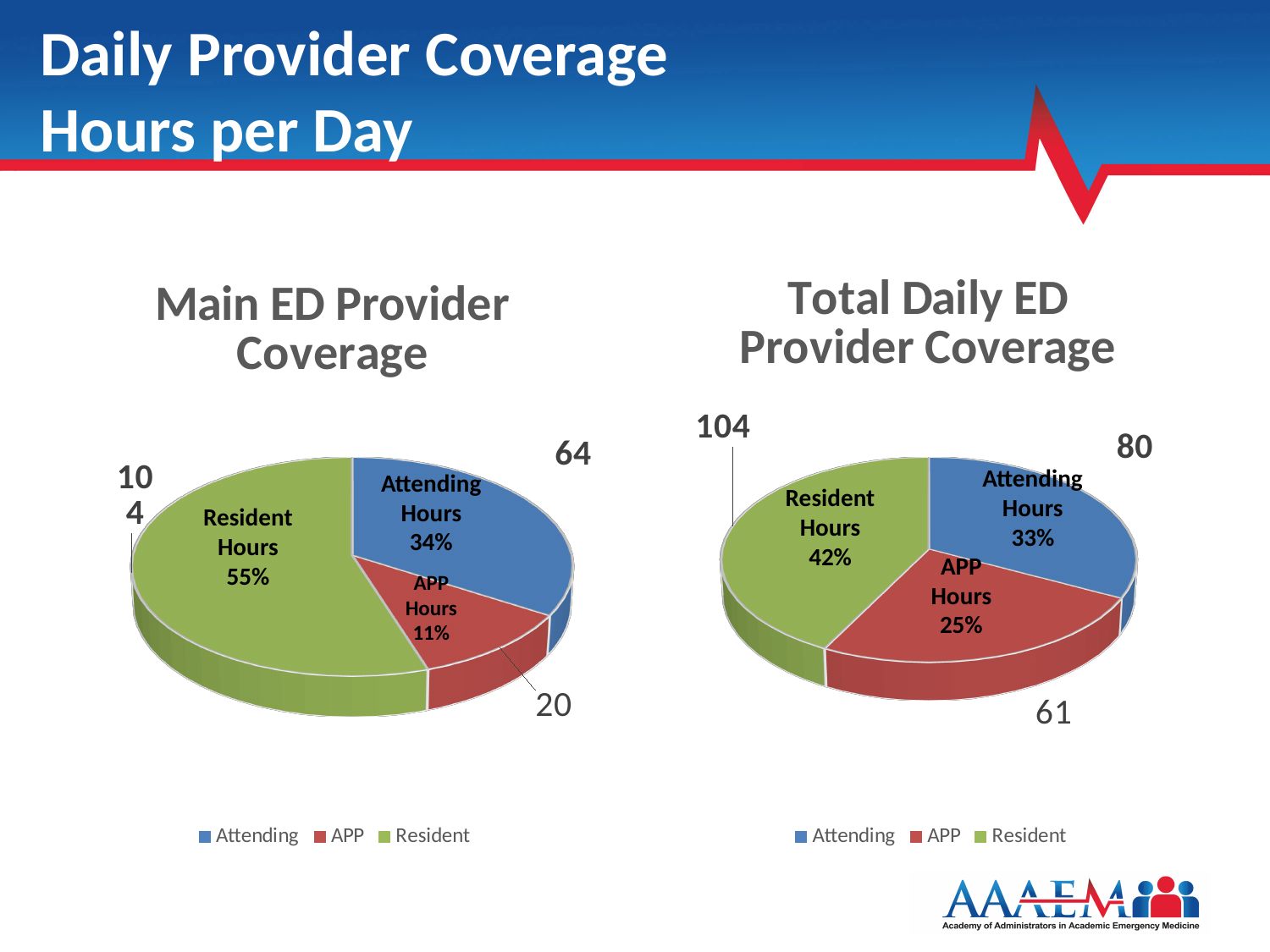
In the Main ED Provider Coverage chart, what percentage share do Resident Hours have? 55% In the Total Daily ED Provider Coverage chart, what is the difference between the Attending Hours value and the APP Hours value? 19 In the Main ED Provider Coverage chart, what value is labelled for APP Hours? 20 In the Total Daily ED Provider Coverage chart, what percentage share do APP Hours have? 25% In the Total Daily ED Provider Coverage chart, what value is labelled for Attending Hours? 80 In the Total Daily ED Provider Coverage chart, which category has the largest share? Resident Hours In the Main ED Provider Coverage chart, what value is labelled for Attending Hours? 64 What kind of chart is the Main ED Provider Coverage chart? Pie chart In the Main ED Provider Coverage chart, what percentage share do APP Hours have? 11% How many entries does the legend of the Total Daily ED Provider Coverage chart list? 3 In the Total Daily ED Provider Coverage chart, what value is labelled for Resident Hours? 104 In the Main ED Provider Coverage chart, which category has the smallest share? APP Hours